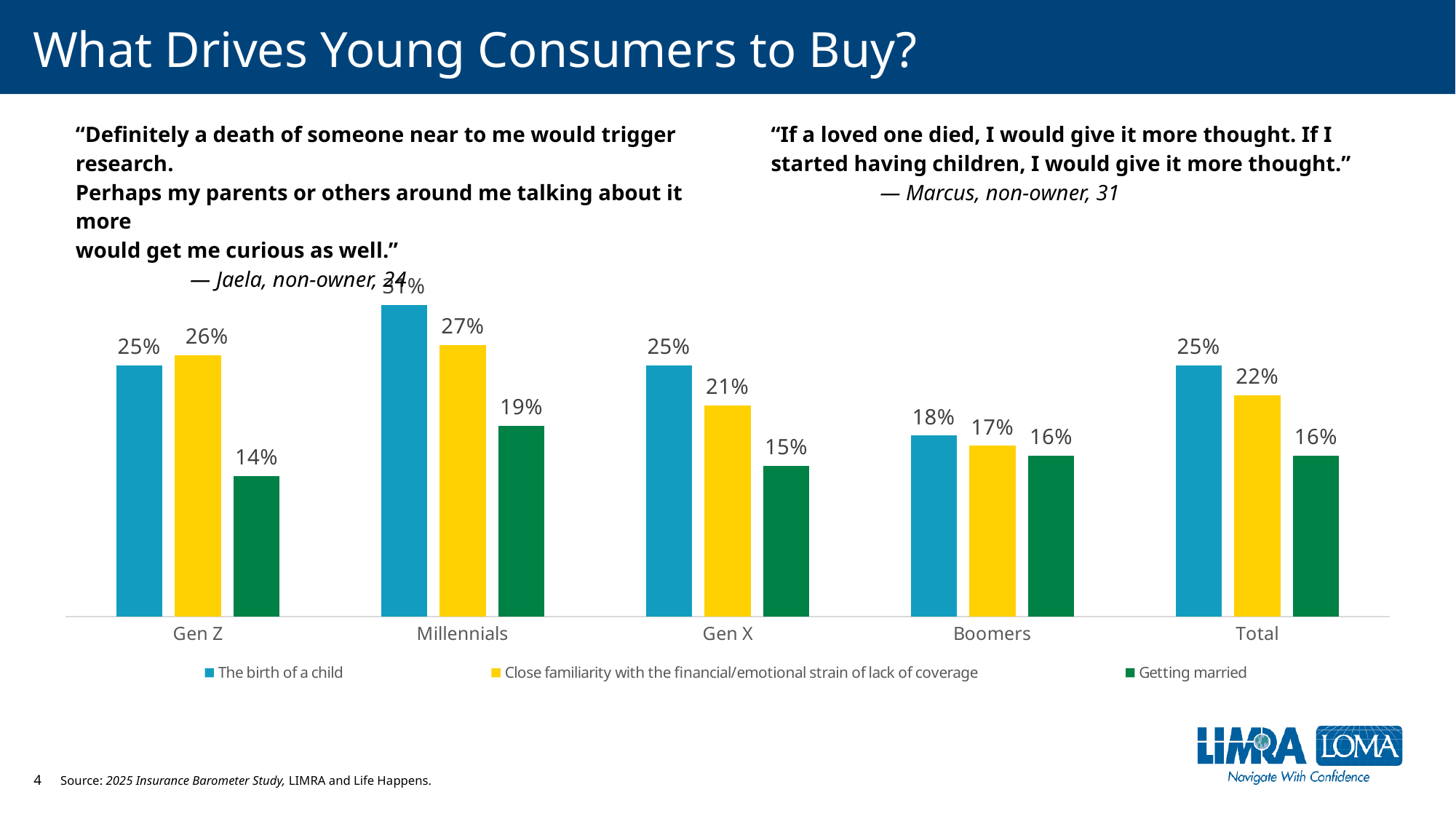
What is the value for 'Getting married' for Gen Z? 14% What is the value for 'The birth of a child' for Millennials? 31% What is the value for 'Close familiarity with the financial/emotional strain of lack of coverage' for Boomers? 17% What is the value for 'Getting married' in the Total category? 16% Which colour represents 'Getting married' in the chart? Green For Gen Z, which is larger: 'The birth of a child' or 'Close familiarity with the financial/emotional strain of lack of coverage'? Close familiarity with the financial/emotional strain of lack of coverage Which generation has the highest value for 'The birth of a child'? Millennials How many generation categories are shown on the x axis? 5 Which category has the lowest value for 'Getting married'? Gen Z What kind of chart is shown on the slide? Bar chart What is the difference between 'The birth of a child' and 'Getting married' for Millennials? 12% How many series does the legend list? 3